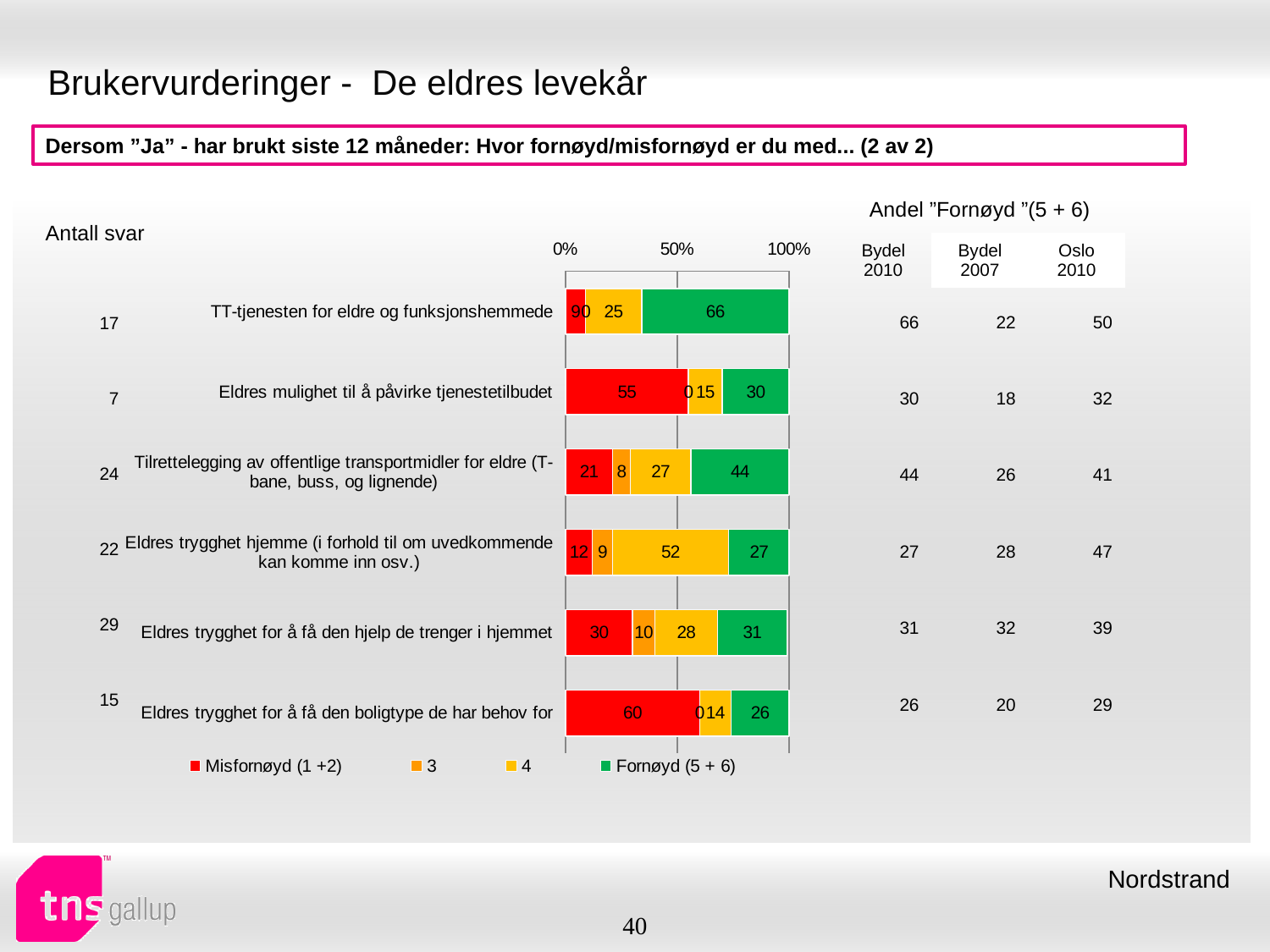
How many series does the chart legend list? 4 What is the Fornøyd (5 + 6) value for 'TT-tjenesten for eldre og funksjonshemmede'? 66 What is the value of series '3' for 'Tilrettelegging av offentlige transportmidler for eldre (T-bane, buss, og lignende)'? 8 What is the value of series '4' for 'Eldres trygghet hjemme (i forhold til om uvedkommende kan komme inn osv.)'? 52 What is the difference between the Fornøyd (5 + 6) values for 'TT-tjenesten for eldre og funksjonshemmede' and 'Eldres mulighet til å påvirke tjenestetilbudet'? 36 What colour represents the Fornøyd (5 + 6) series in the chart? Green Which category has the highest Misfornøyd (1 +2) value? Eldres trygghet for å få den boligtype de har behov for What is the Misfornøyd (1 +2) value for 'Eldres trygghet for å få den boligtype de har behov for'? 60 Which has the larger Misfornøyd (1 +2) value: 'Eldres mulighet til å påvirke tjenestetilbudet' or 'Tilrettelegging av offentlige transportmidler for eldre (T-bane, buss, og lignende)'? Eldres mulighet til å påvirke tjenestetilbudet What kind of chart is shown on the slide? Stacked bar chart How many categories (rows) does the bar chart show? 6 Which category has the highest Fornøyd (5 + 6) value? TT-tjenesten for eldre og funksjonshemmede